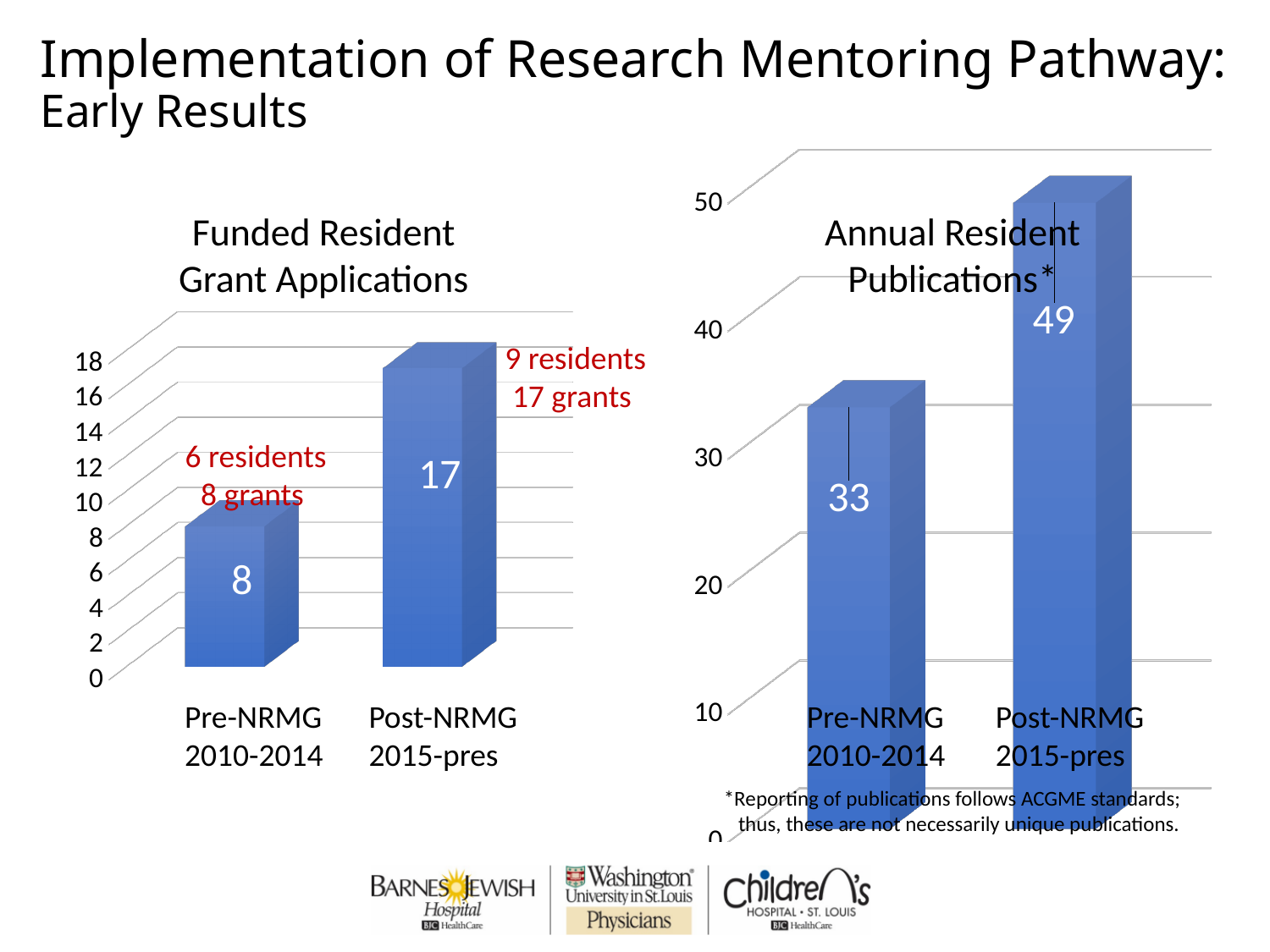
In the 'Funded Resident Grant Applications' chart, what is the value for Post-NRMG 2015-pres? 17 In the 'Annual Resident Publications*' chart, which category has the lowest value? Pre-NRMG 2010-2014 In the 'Funded Resident Grant Applications' chart, do the values rise or fall from Pre-NRMG to Post-NRMG? rise In the 'Annual Resident Publications*' chart, is the value for Pre-NRMG 2010-2014 greater or less than 40? less How many categories are shown in the 'Funded Resident Grant Applications' chart? 2 In the 'Funded Resident Grant Applications' chart, what is the value for Pre-NRMG 2010-2014? 8 In the 'Funded Resident Grant Applications' chart, which category has the highest value? Post-NRMG 2015-pres What kind of chart is the 'Annual Resident Publications*' chart? bar chart In the 'Annual Resident Publications*' chart, what is the value for Post-NRMG 2015-pres? 49 In the 'Annual Resident Publications*' chart, what is the value for Pre-NRMG 2010-2014? 33 In the 'Funded Resident Grant Applications' chart, what is the difference between the Post-NRMG and Pre-NRMG values? 9 In the 'Annual Resident Publications*' chart, what is the difference between the Post-NRMG and Pre-NRMG values? 16